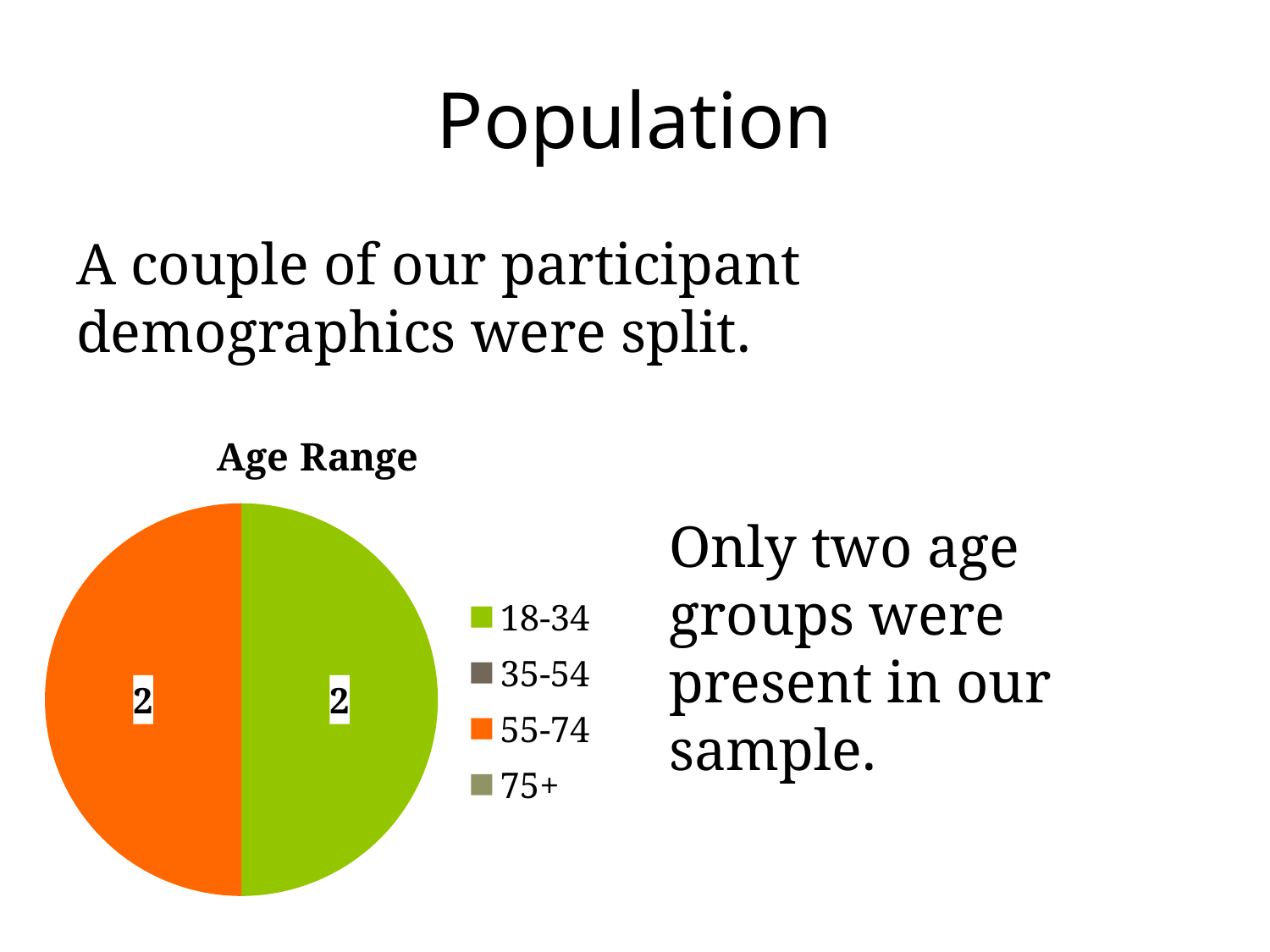
What is the value shown for the 18-34 slice? 2 What is the title of the chart? Age Range What is the difference between the values for 18-34 and 55-74? 0 How many slices are actually visible in the pie? 2 Which colour represents the 55-74 age group in the chart? orange What share of the pie does the 18-34 slice represent? 50% What share of the pie does the 55-74 slice represent? 50% What kind of chart is shown on the slide? pie chart How many entries does the chart's legend list? 4 What is the value shown for the 55-74 slice? 2 Which legend entries have no visible slice in the pie? 35-54 and 75+ What is the total of the values shown on the pie slices? 4